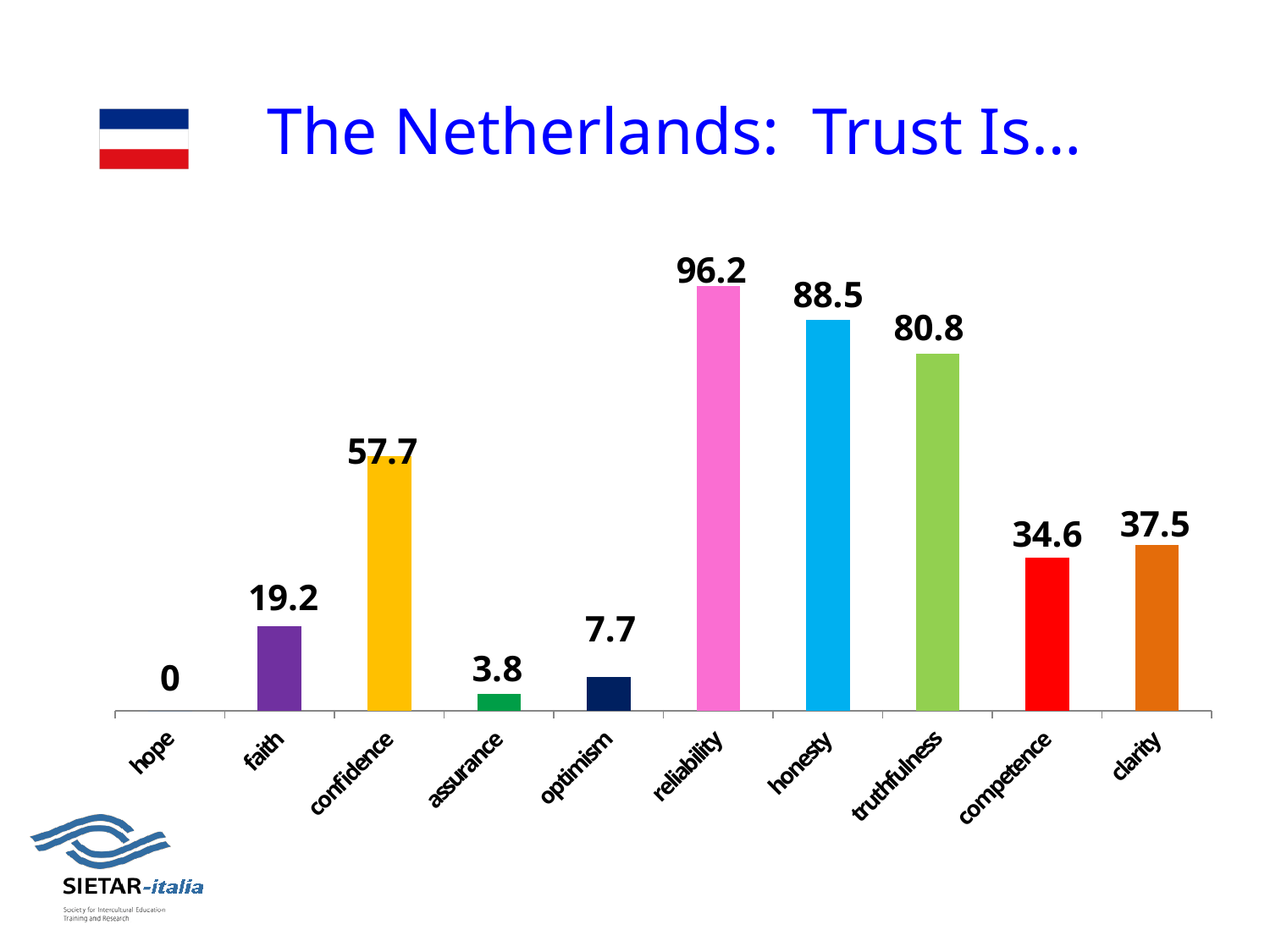
How many categories are shown on the x axis? 10 What is the value for reliability? 96.2 What is the title of the slide? The Netherlands: Trust Is... What is the value for assurance? 3.8 What is the value for confidence? 57.7 Which category has the highest value? reliability What is the difference between the values for honesty and truthfulness? 7.7 What kind of chart is shown on the slide? bar chart Which is larger, the value for faith or the value for optimism? faith What is the value for clarity? 37.5 What is the difference between the values for clarity and competence? 2.9 Which category has the lowest value? hope